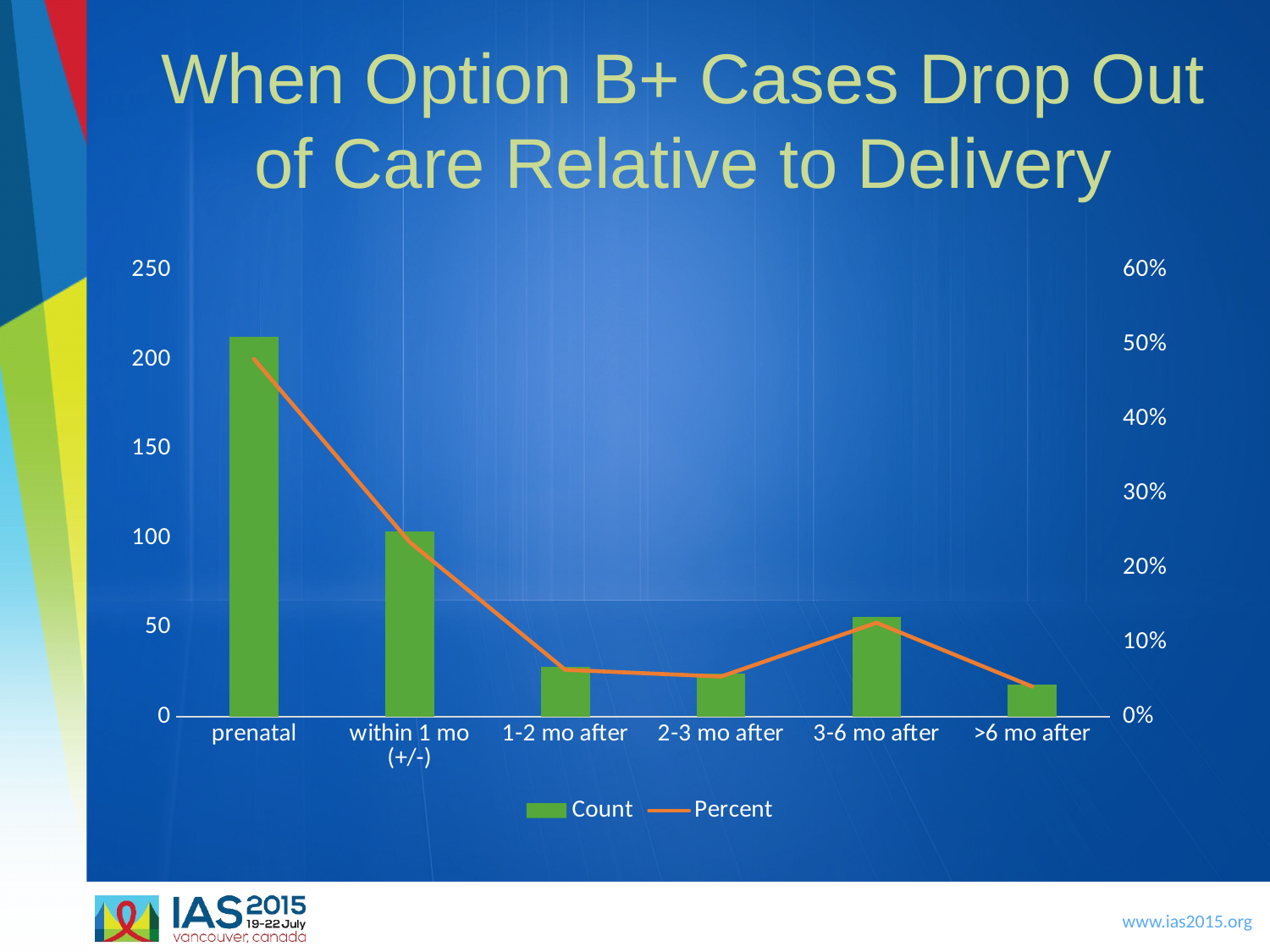
Which has the larger Count, 2-3 mo after or 3-6 mo after? 3-6 mo after What is the title of the chart? When Option B+ Cases Drop Out of Care Relative to Delivery Which has the larger Count, prenatal or within 1 mo (+/-)? prenatal From prenatal to 2-3 mo after, do the Count values rise or fall? fall Is the Count for prenatal greater or less than 200? greater How many series does the legend list? 2 What kind of chart is shown on the slide? A combined bar and line chart Is the Count for 3-6 mo after greater or less than 100? less How many categories are shown on the x axis? 6 Is the Count for within 1 mo (+/-) greater or less than 150? less Which category has the highest Count? prenatal